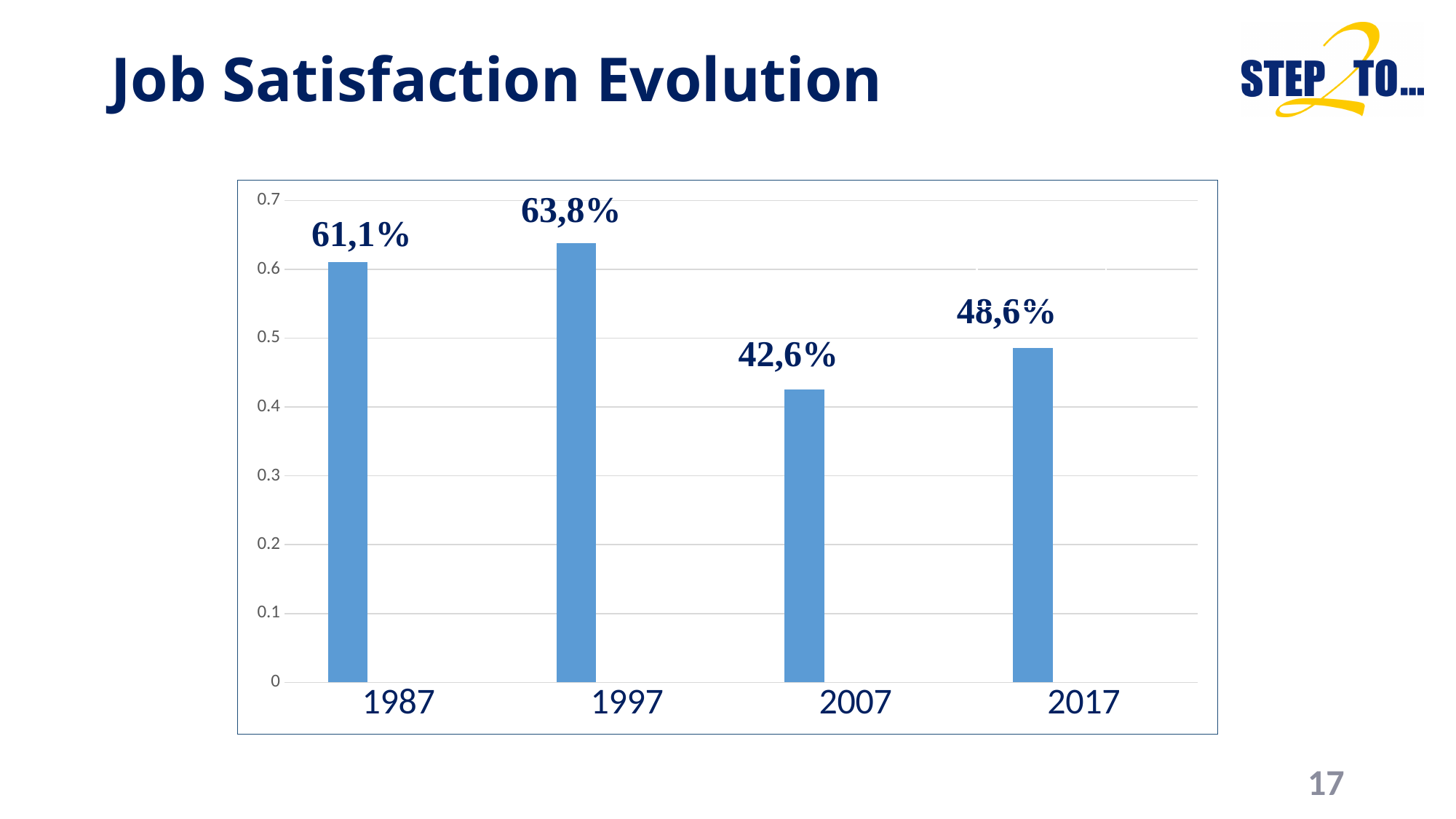
What is the title of the slide containing the chart? Job Satisfaction Evolution Which year has the lowest job satisfaction value? 2007 What kind of chart is shown on the slide? bar chart What is the job satisfaction value for 2017? 48,6% Which is larger, the value for 1987 or the value for 2017? 1987 What is the job satisfaction value for 2007? 42,6% What is the difference between the 1997 and 2007 values? 21,2% What is the difference between the 2017 and 2007 values? 6,0% Which year has the highest job satisfaction value? 1997 Is the value for 2017 greater or less than 0.5? less How many years are shown on the x axis? 4 What is the job satisfaction value for 1987? 61,1%